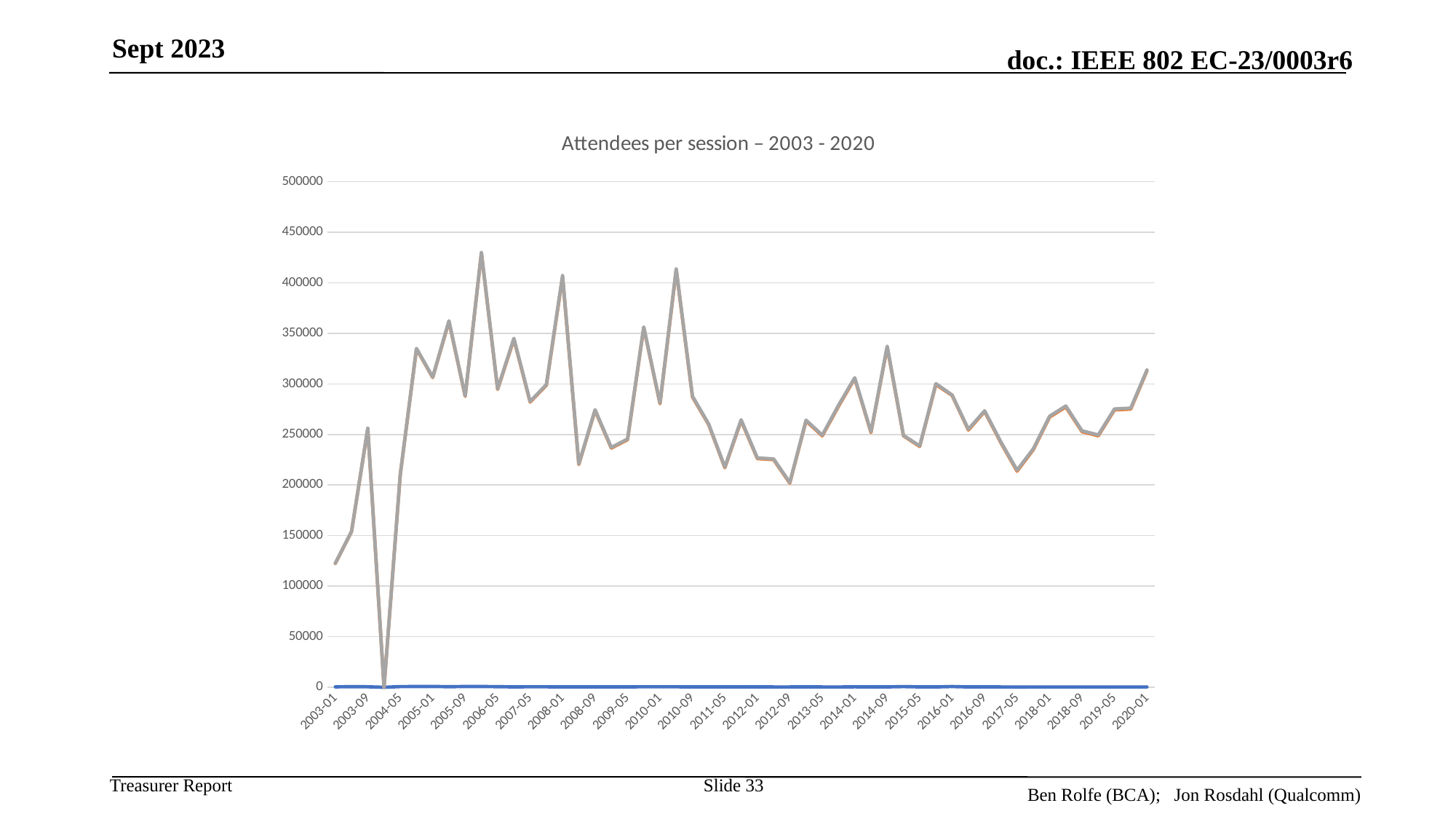
Is the value for 2014-09 greater or less than 300000? greater Which has the higher value, 2003-01 or 2020-01? 2020-01 Is the value for 2020-01 greater or less than 300000? greater What is the title of the chart? Attendees per session – 2003 - 2020 Does the line rise or fall between 2017-05 and 2020-01? rise Is the value for 2006-05 greater or less than 400000? less What kind of chart is shown on the slide? line chart Which has the higher value, 2006-05 or 2020-01? 2020-01